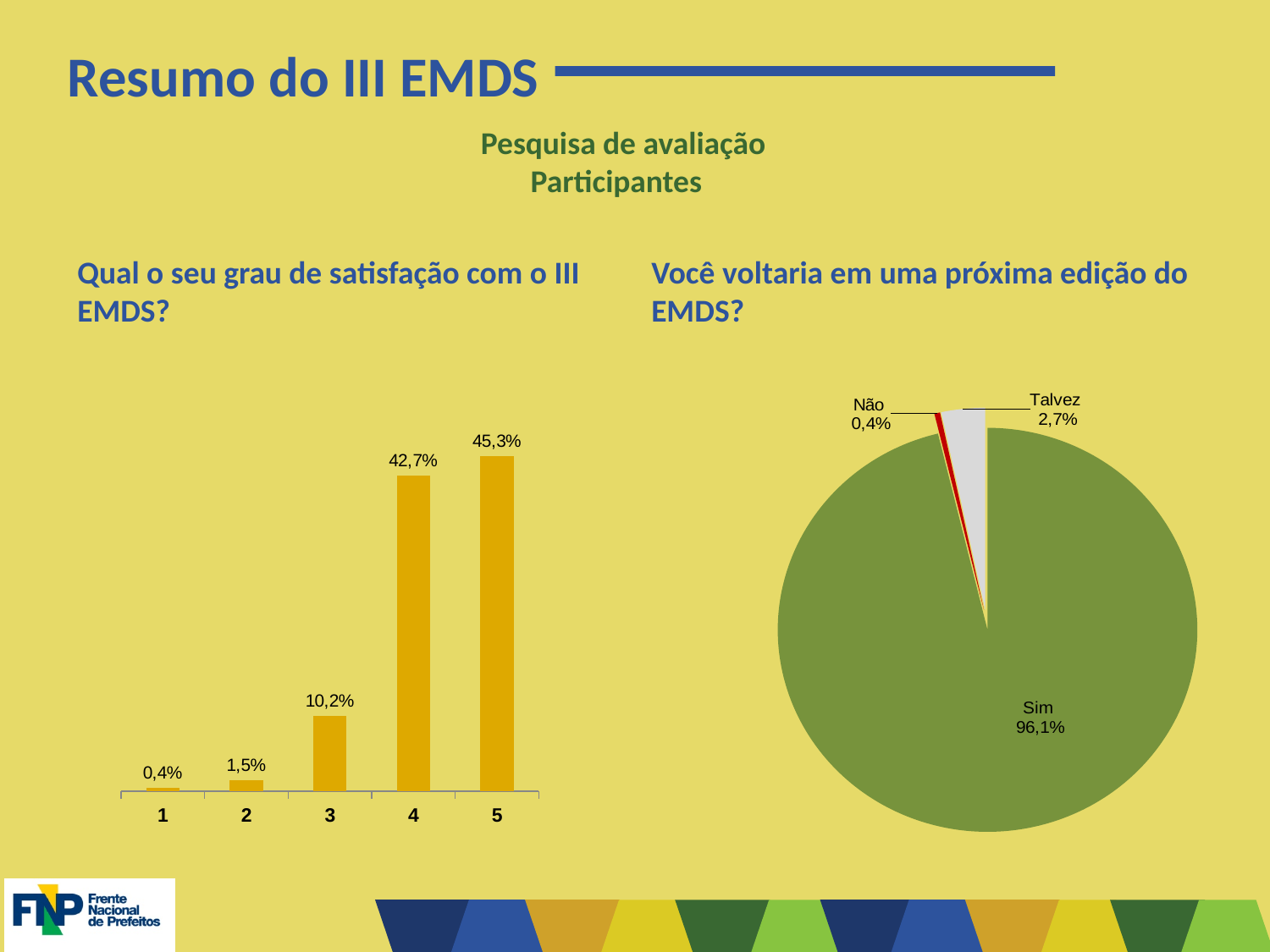
In the bar chart on the left (satisfaction with III EMDS), do the values rise or fall from category 1 to category 5? rise In the bar chart on the left (satisfaction with III EMDS), how many categories are shown? 5 In the pie chart on the right (would you return to a next edition of EMDS), which slice is the smallest? Não In the bar chart on the left (satisfaction with III EMDS), which category has the highest value? 5 In the bar chart on the left (satisfaction with III EMDS), what is the value for category 4? 42,7% In the pie chart on the right (would you return to a next edition of EMDS), what is the value for 'Talvez'? 2,7% What kind of chart is the chart on the left (satisfaction with III EMDS)? bar chart In the bar chart on the left (satisfaction with III EMDS), which is larger, the value for category 2 or category 3? 3 In the bar chart on the left (satisfaction with III EMDS), what is the value for category 3? 10,2% In the bar chart on the left (satisfaction with III EMDS), which category has the lowest value? 1 In the bar chart on the left (satisfaction with III EMDS), what is the difference between the values for categories 5 and 4? 2,6% In the pie chart on the right (would you return to a next edition of EMDS), what share does 'Sim' have? 96,1%